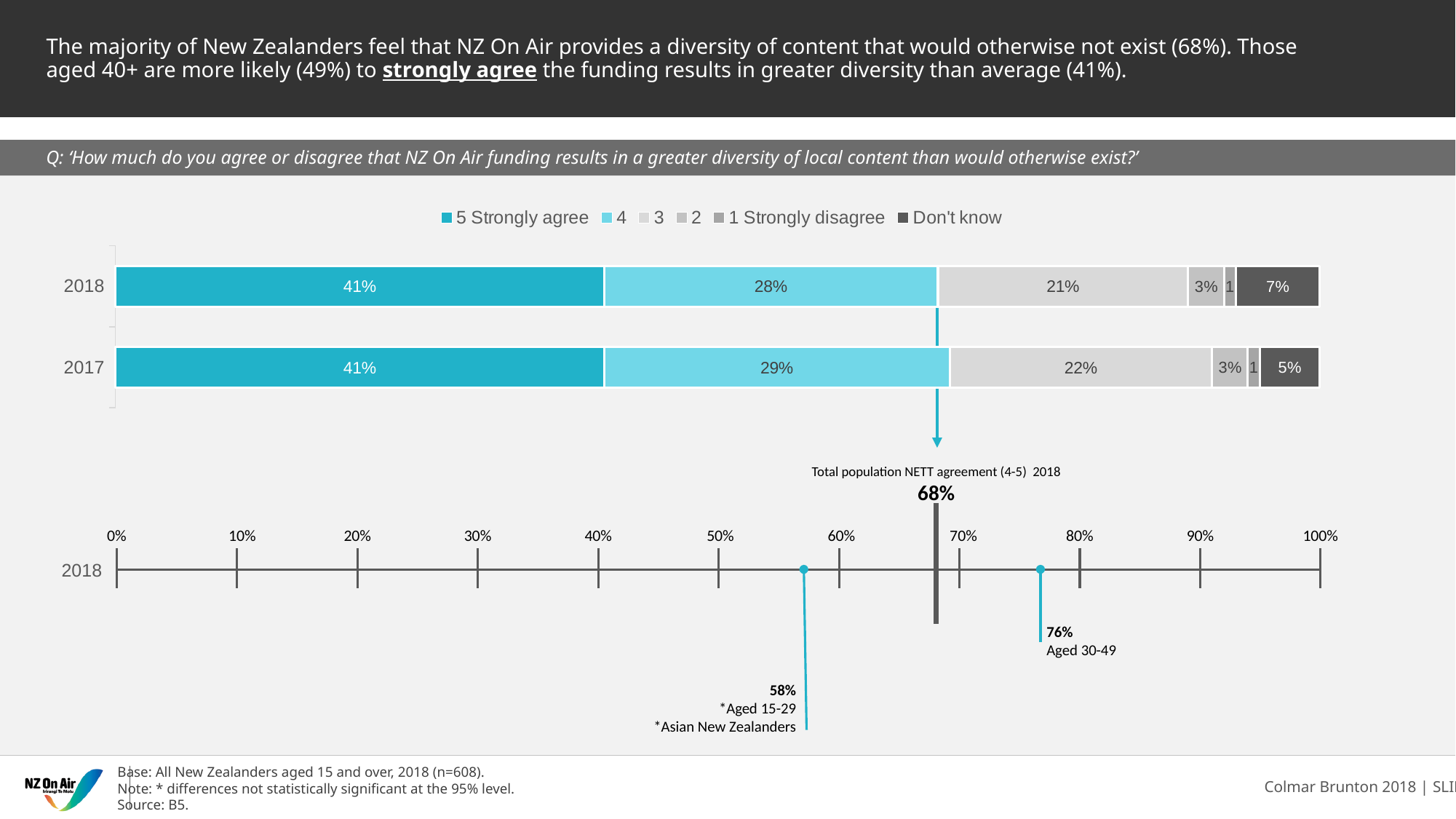
In the stacked bar chart, what percentage of respondents in 2018 chose '5 Strongly agree'? 41% In the stacked bar chart, what is the 'Don't know' value for 2018? 7% In the stacked bar chart, what is the 'Don't know' value for 2017? 5% In the stacked bar chart, by how many percentage points does the 'Don't know' share for 2018 exceed that for 2017? 2 percentage points In the stacked bar chart, which year has the larger share for rating '3', 2018 or 2017? 2017 How many years (bars) are shown in the stacked bar chart? 2 In the lower chart, what is the total population NETT agreement (4-5) for 2018? 68% In the lower chart, what is the NETT agreement for those aged 30-49? 76% In the stacked bar chart, what percentage of respondents in 2017 chose '4'? 29% How many series does the legend of the stacked bar chart list? 6 What kind of chart is the upper chart showing the 2018 and 2017 results? Stacked bar chart In the lower chart, what is the difference in NETT agreement between those aged 30-49 (76%) and those aged 15-29 (58%)? 18 percentage points